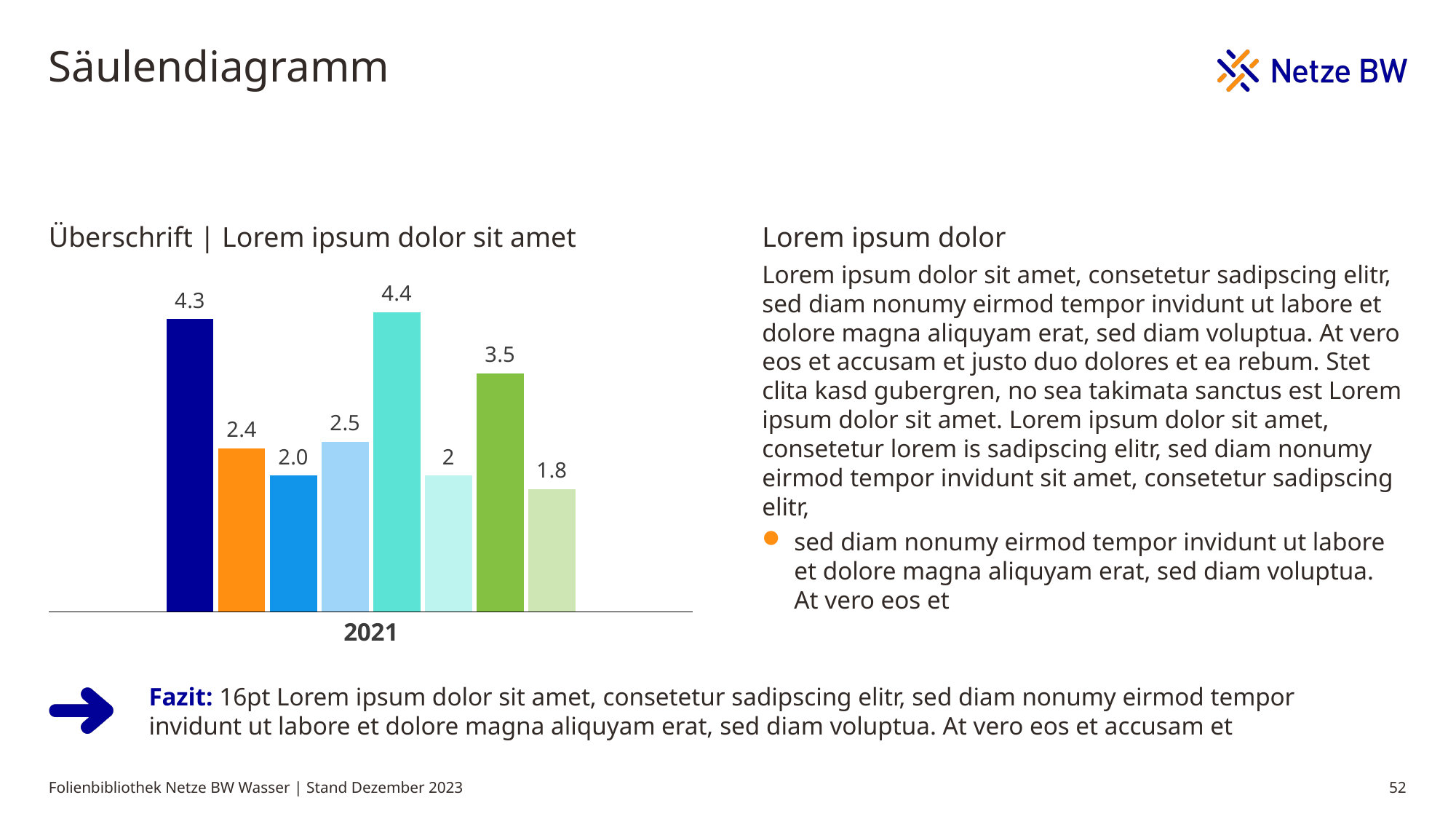
What is the highest value labelled on any bar in the chart? 4.4 What value is labelled on the last (rightmost) bar? 1.8 What is the only category label shown on the x axis of the chart? 2021 What value is labelled on the green bar (seventh from the left)? 3.5 What is the lowest value labelled on any bar in the chart? 1.8 How many bars are plotted in the chart? 8 Which bar is taller: the dark blue first bar or the turquoise fifth bar? the turquoise fifth bar What value is labelled on the orange bar? 2.4 What kind of chart is shown on the slide? bar chart What value is labelled on the first (dark blue) bar from the left? 4.3 What is the title printed above the chart? Überschrift | Lorem ipsum dolor sit amet What is the difference between the tallest bar (4.4) and the shortest bar (1.8)? 2.6